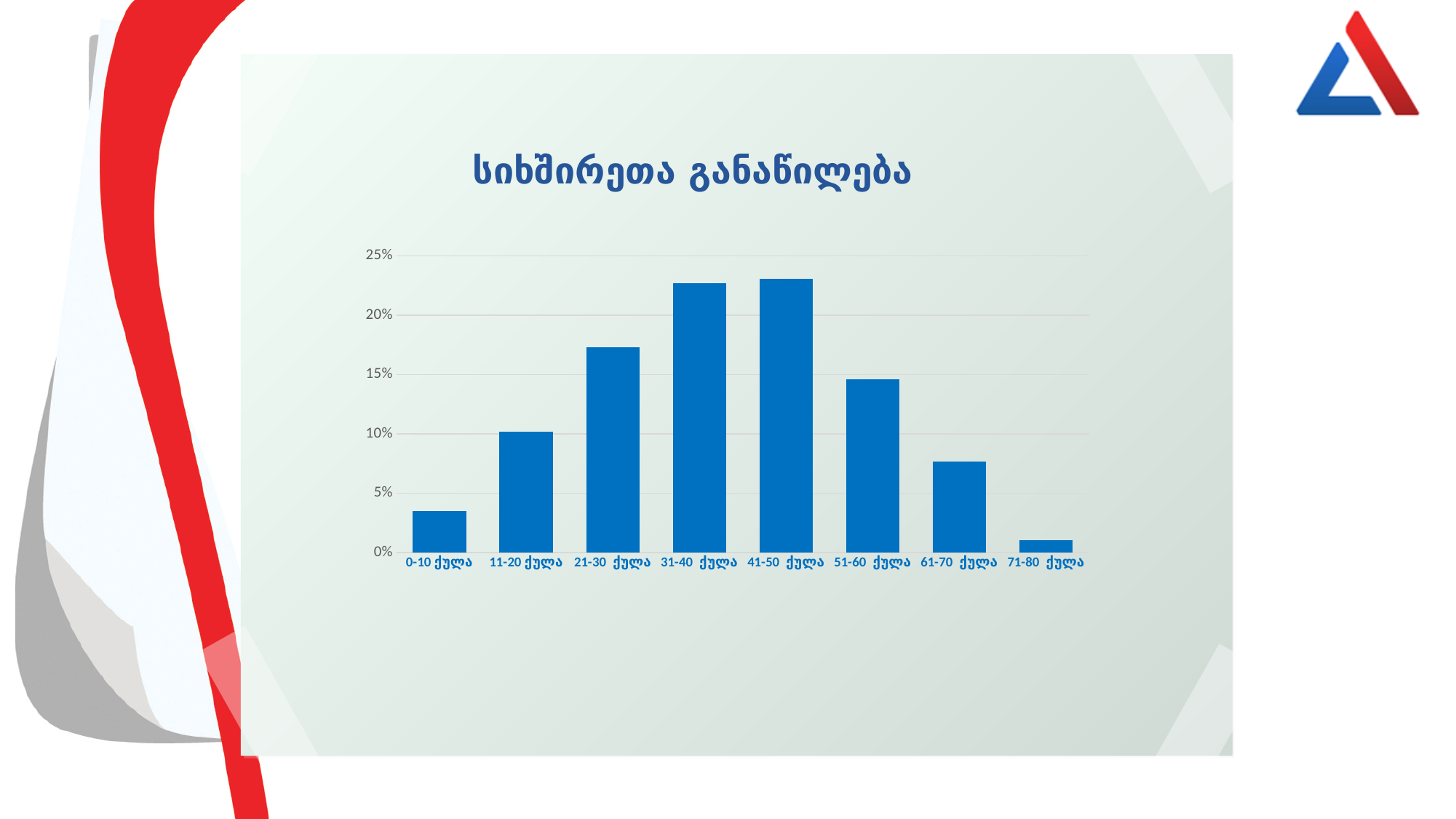
Do the values rise or fall from 41-50 ქულა to 71-80 ქულა along the x axis? fall Is the value for 0-10 ქულა greater or less than 5%? less Which category has the lowest value in the chart? 71-80 ქულა Is the value for 51-60 ქულა greater or less than 15%? less How many categories are shown on the x axis of the chart? 8 Is the value for 31-40 ქულა greater or less than 20%? greater What kind of chart is shown on the slide? bar chart What is the title of the chart? სიხშირეთა განაწილება Which is larger, the value for 21-30 ქულა or the value for 51-60 ქულა? 21-30 ქულა Which is larger, the value for 11-20 ქულა or the value for 61-70 ქულა? 11-20 ქულა